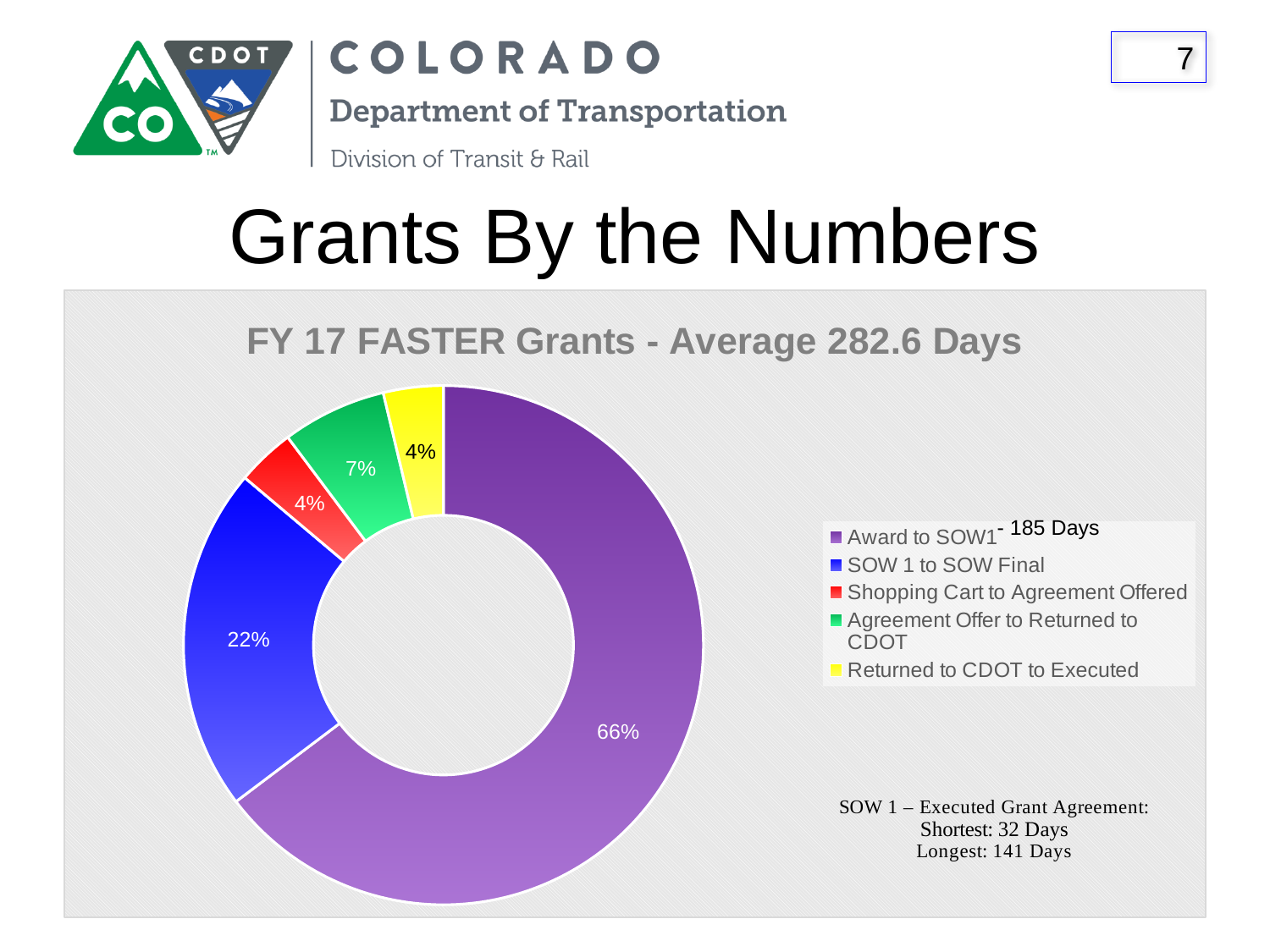
What percentage is shown for the Agreement Offer to Returned to CDOT slice? 7% How many slices does the chart have? 5 What is the title of the chart? FY 17 FASTER Grants - Average 282.6 Days What colour is the Award to SOW1 slice? Purple What kind of chart is shown on the slide? Doughnut (pie) chart What percentage is shown for the SOW 1 to SOW Final slice? 22% Which is larger: the SOW 1 to SOW Final share or the Agreement Offer to Returned to CDOT share? SOW 1 to SOW Final What percentage is shown for the Returned to CDOT to Executed slice? 4% By how many percentage points does the Award to SOW1 share exceed the SOW 1 to SOW Final share? 44 percentage points What share of the doughnut chart is labelled Award to SOW1? 66% What percentage is shown for the Shopping Cart to Agreement Offered slice? 4% Which category takes up the largest share of the chart? Award to SOW1